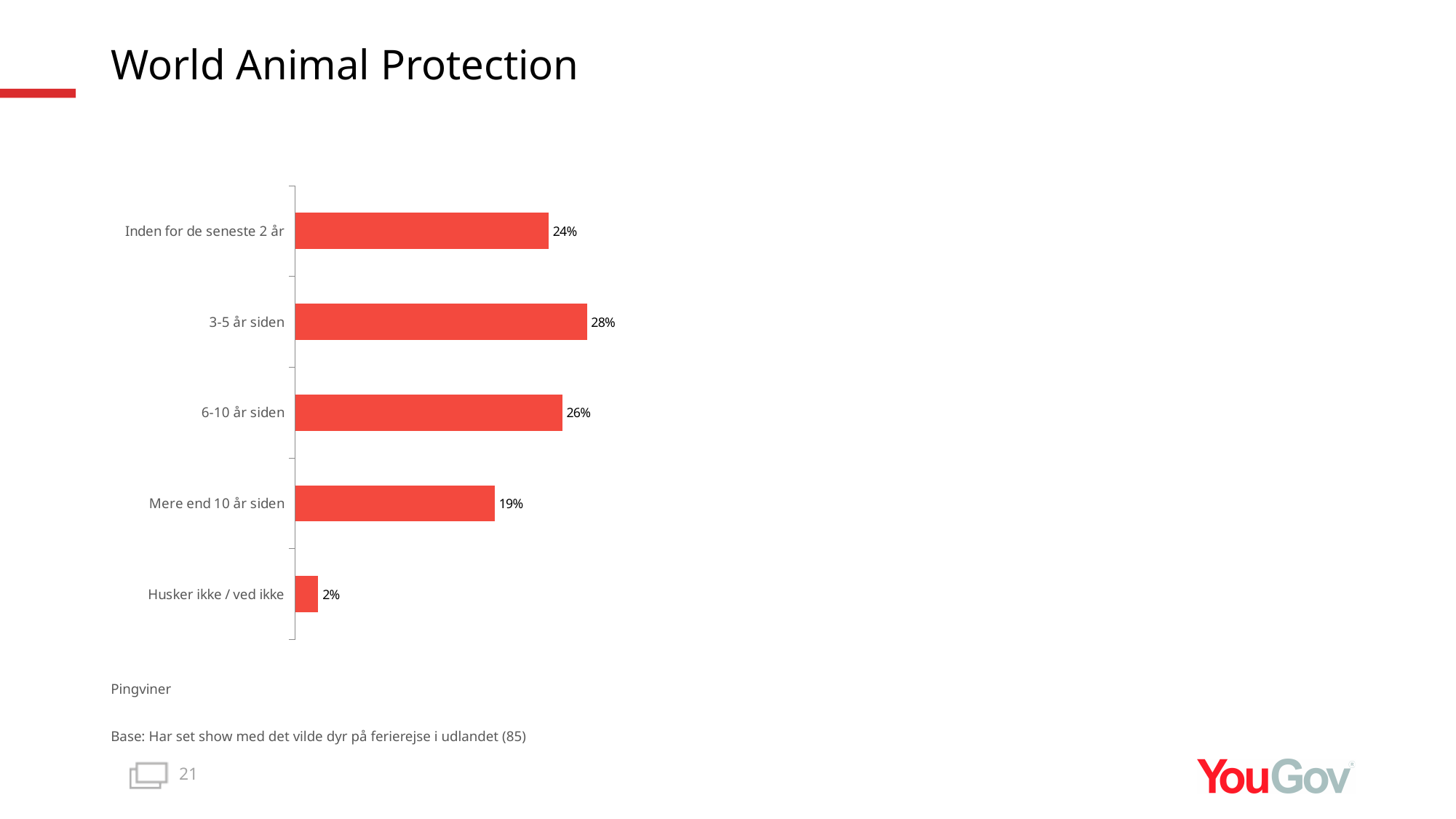
What is the base size stated below the chart? 85 What colour are the bars in the chart? Red What is the value for "3-5 år siden"? 28% How many categories are shown in the chart? 5 What is the difference between "6-10 år siden" and "Husker ikke / ved ikke"? 24 percentage points What is the value for "Husker ikke / ved ikke"? 2% Which category has the highest value? 3-5 år siden Which is larger: "6-10 år siden" or "Mere end 10 år siden"? 6-10 år siden What is the value for "Mere end 10 år siden"? 19% What kind of chart is shown on the slide? Bar chart Which category has the lowest value? Husker ikke / ved ikke What is the difference between "3-5 år siden" and "Inden for de seneste 2 år"? 4 percentage points